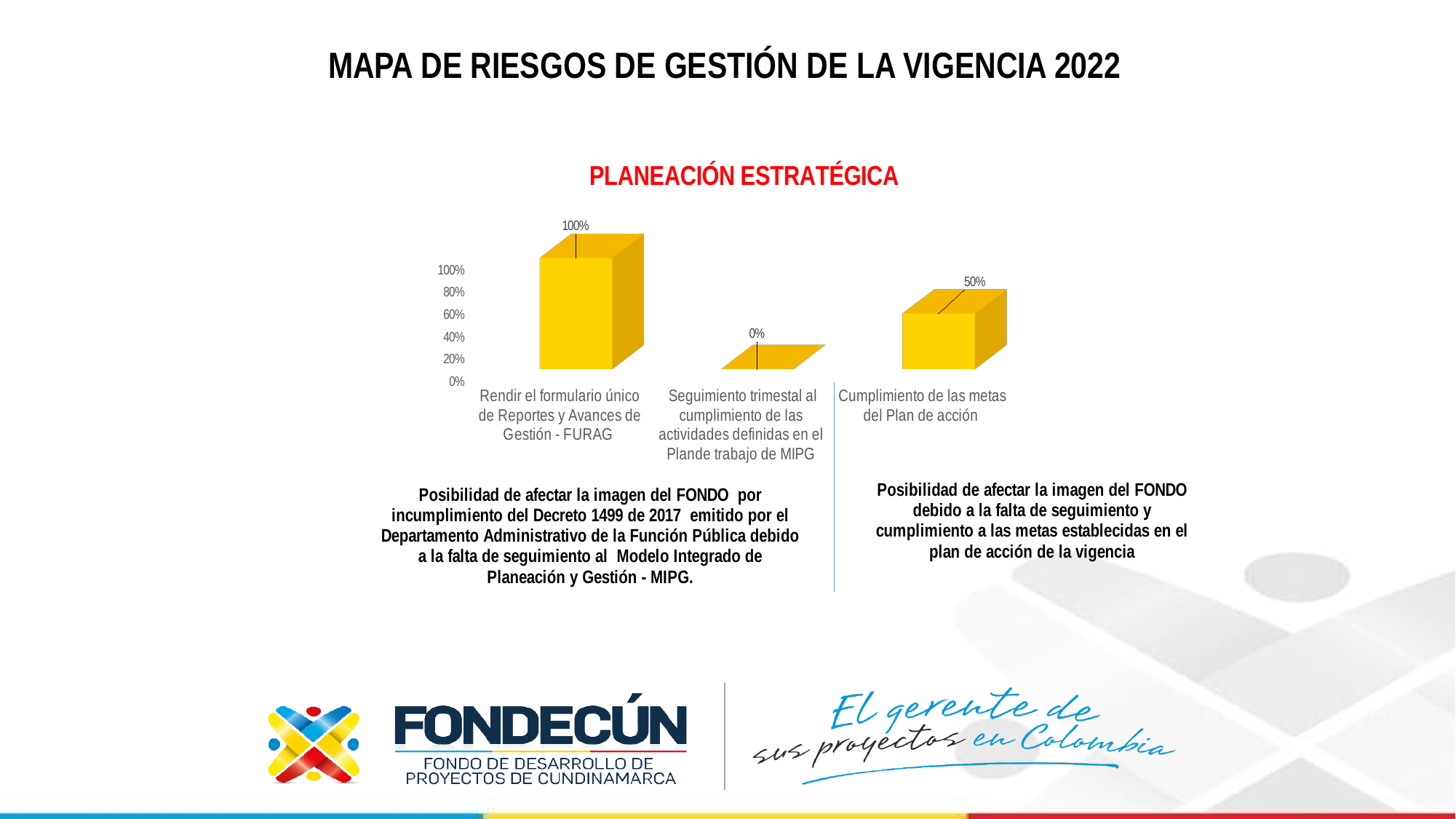
What is the value for 'Rendir el formulario único de Reportes y Avances de Gestión - FURAG'? 100% How many categories are shown in the chart? 3 Which category has the highest value? Rendir el formulario único de Reportes y Avances de Gestión - FURAG What is the title shown above the chart? PLANEACIÓN ESTRATÉGICA What is the difference between the value for 'Rendir el formulario único de Reportes y Avances de Gestión - FURAG' and the value for 'Cumplimiento de las metas del Plan de acción'? 50% What is the highest value shown on the vertical axis of the chart? 100% Which is larger: the value for 'Cumplimiento de las metas del Plan de acción' or the value for 'Seguimiento trimestal al cumplimiento de las actividades definidas en el Plande trabajo de MIPG'? Cumplimiento de las metas del Plan de acción Is the value for 'Cumplimiento de las metas del Plan de acción' greater or less than 80%? less What kind of chart is shown on the slide? bar chart What is the value for 'Seguimiento trimestal al cumplimiento de las actividades definidas en el Plande trabajo de MIPG'? 0% Which category has the lowest value? Seguimiento trimestal al cumplimiento de las actividades definidas en el Plande trabajo de MIPG What is the value for 'Cumplimiento de las metas del Plan de acción'? 50%